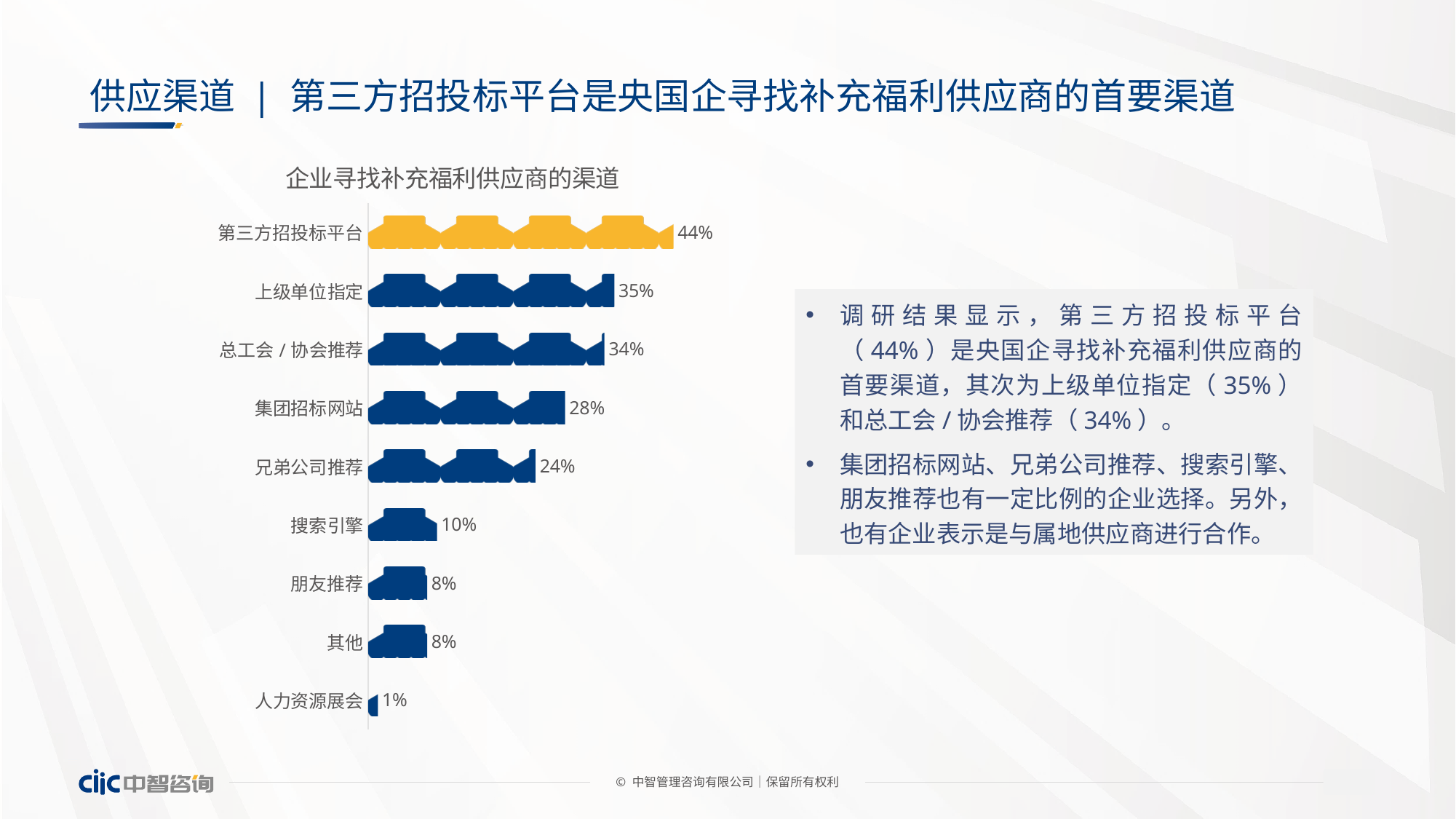
What is the value for 第三方招投标平台? 44% What kind of chart is shown on the slide? Bar chart Which is larger, the value for 集团招标网站 or the value for 兄弟公司推荐? 集团招标网站 What is the value for 集团招标网站? 28% What is the difference between the values for 第三方招投标平台 and 兄弟公司推荐? 20% What is the difference between the values for 上级单位指定 and 总工会 / 协会推荐? 1% Which category has the highest value? 第三方招投标平台 What is the title of the chart? 企业寻找补充福利供应商的渠道 Which bar is coloured differently (yellow) from the others? 第三方招投标平台 Which category has the lowest value? 人力资源展会 What is the value for 搜索引擎? 10% How many categories are shown in the chart? 9